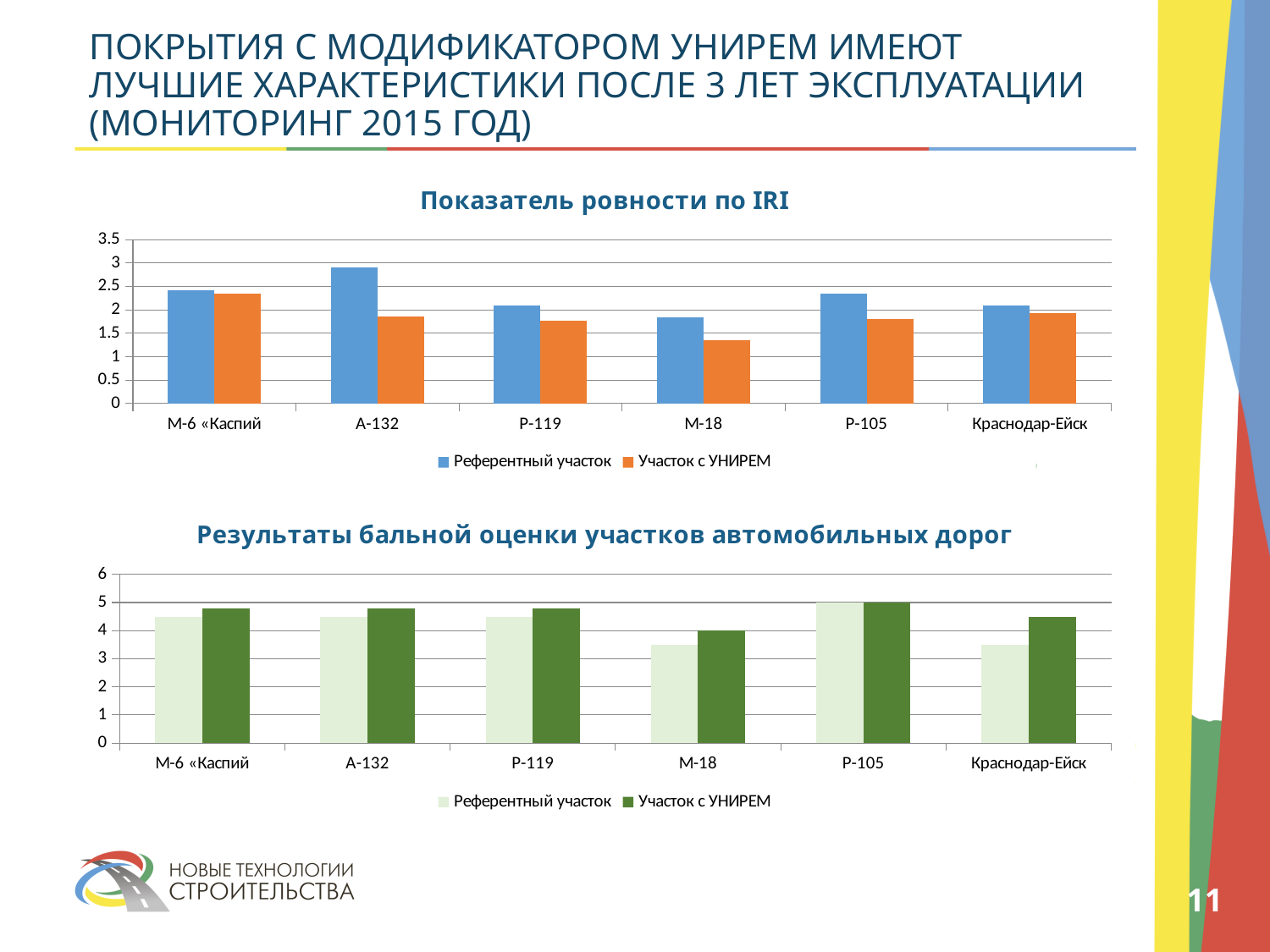
How many series does the legend of the chart 'Показатель ровности по IRI' list? 2 In the chart 'Результаты бальной оценки участков автомобильных дорог', which category has the lowest value for Участок с УНИРЕМ? М-18 In the chart 'Показатель ровности по IRI', which category has the lowest value for Участок с УНИРЕМ? М-18 In the chart 'Показатель ровности по IRI', is the value for Участок с УНИРЕМ at М-18 greater or less than 1.5? less How many categories are shown on the x axis of the chart 'Показатель ровности по IRI'? 6 In the chart 'Показатель ровности по IRI', which series has the larger value at А-132: Референтный участок or Участок с УНИРЕМ? Референтный участок In the chart 'Показатель ровности по IRI', which category has the highest value for Референтный участок? А-132 In the chart 'Показатель ровности по IRI', is the value for Референтный участок at А-132 greater or less than 2.5? greater In the chart 'Результаты бальной оценки участков автомобильных дорог', which series has the larger value at Краснодар-Ейск: Референтный участок or Участок с УНИРЕМ? Участок с УНИРЕМ What kind of chart is the top chart 'Показатель ровности по IRI'? bar chart In the chart 'Результаты бальной оценки участков автомобильных дорог', is the value for Референтный участок at М-18 greater or less than 4? less What is the title of the bottom chart on the slide? Результаты бальной оценки участков автомобильных дорог